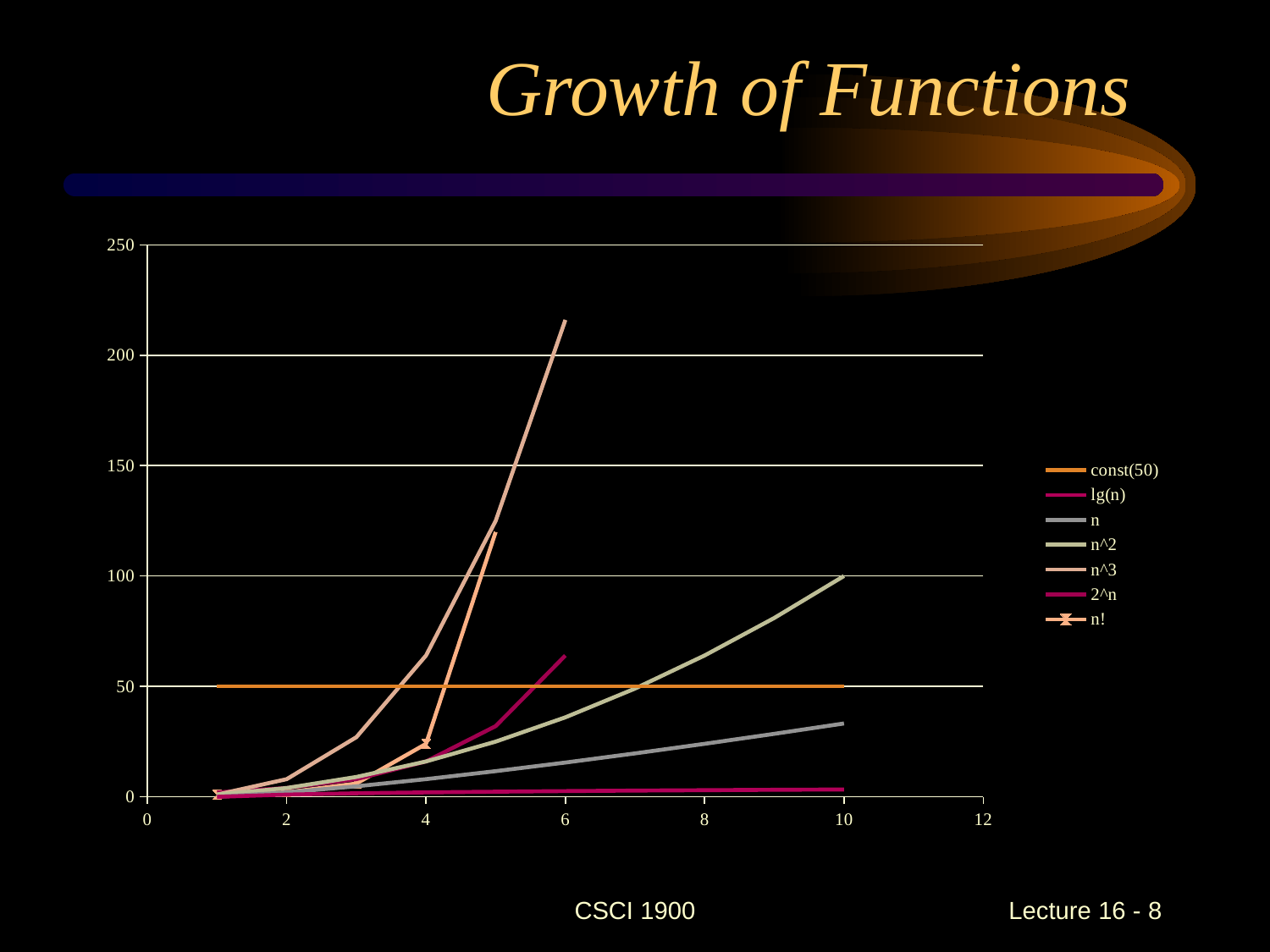
Which series in the legend is drawn with markers on its line? n! Is the value of the n^3 series at x = 6 greater or less than 200? greater Does the n^2 series rise or fall as x increases? rise What is the value of the n^2 series at x = 10? 100 What kind of chart is shown on the slide? line chart How many series does the legend list? 7 Is the value of the n series at x = 10 greater or less than 50? less At x = 10, which is larger, the n^2 series or the n series? n^2 Which series reaches the highest value on the chart? n^3 What is the title of the slide's chart? Growth of Functions At what constant value does the const(50) series run across the chart? 50 Which series stays lowest across the chart? lg(n)